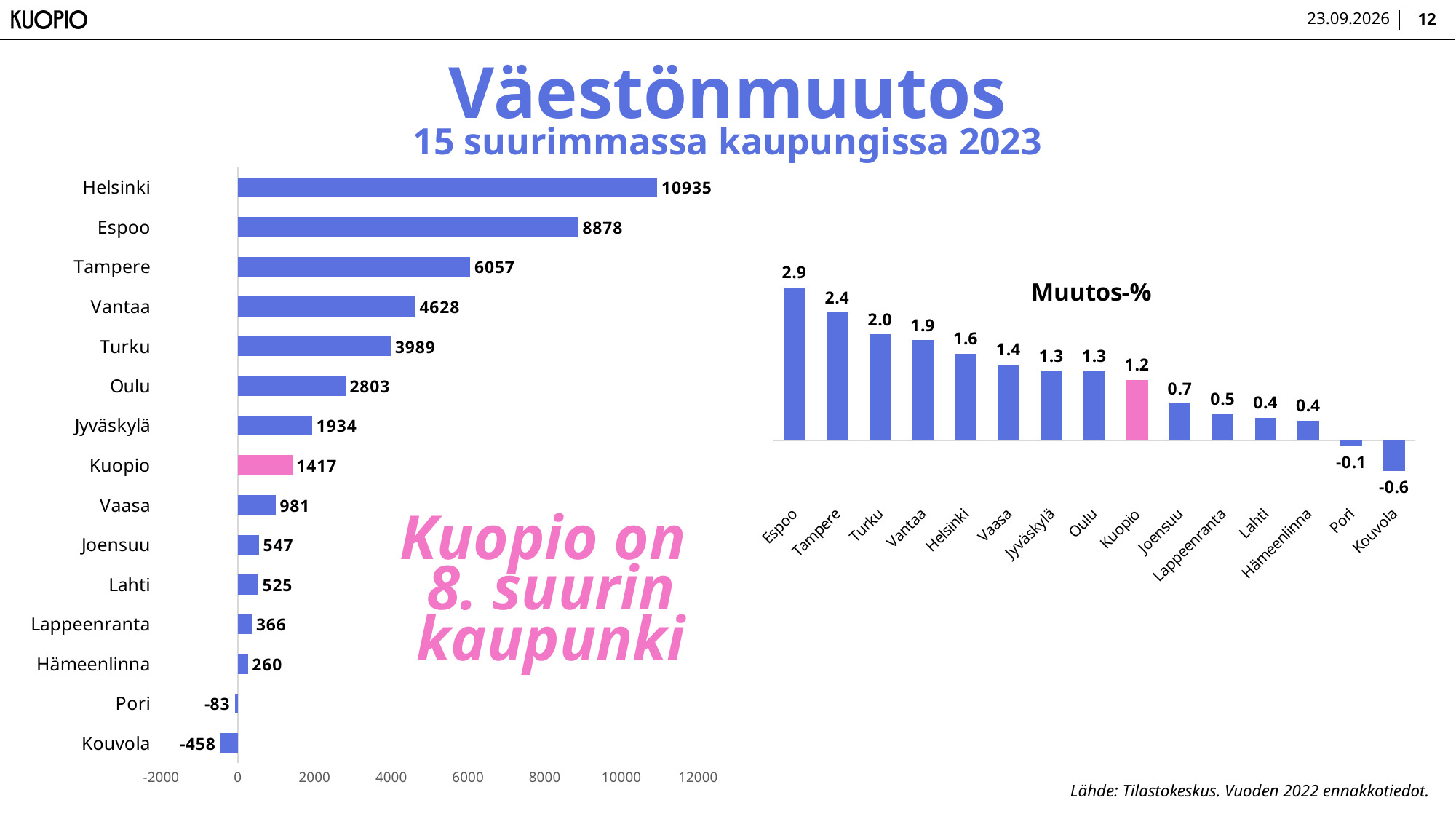
In the left bar chart, what is the value for Kuopio? 1417 In the left bar chart, which is larger, the value for Vantaa or the value for Turku? Vantaa How many cities are shown in the left bar chart? 15 In the left bar chart, which city has the lowest value? Kouvola In the left bar chart, which city's bar is coloured pink instead of blue? Kuopio In the left bar chart, what is the value for Kouvola? -458 In the Muutos-% chart, what is the value for Pori? -0.1 In the left bar chart, which city has the highest value? Helsinki In the left bar chart, what is the difference between the values for Helsinki and Espoo? 2057 In the Muutos-% chart, what is the difference between the values for Tampere and Kuopio? 1.2 In the Muutos-% chart, what is the value for Espoo? 2.9 What kind of chart is the left chart? bar chart